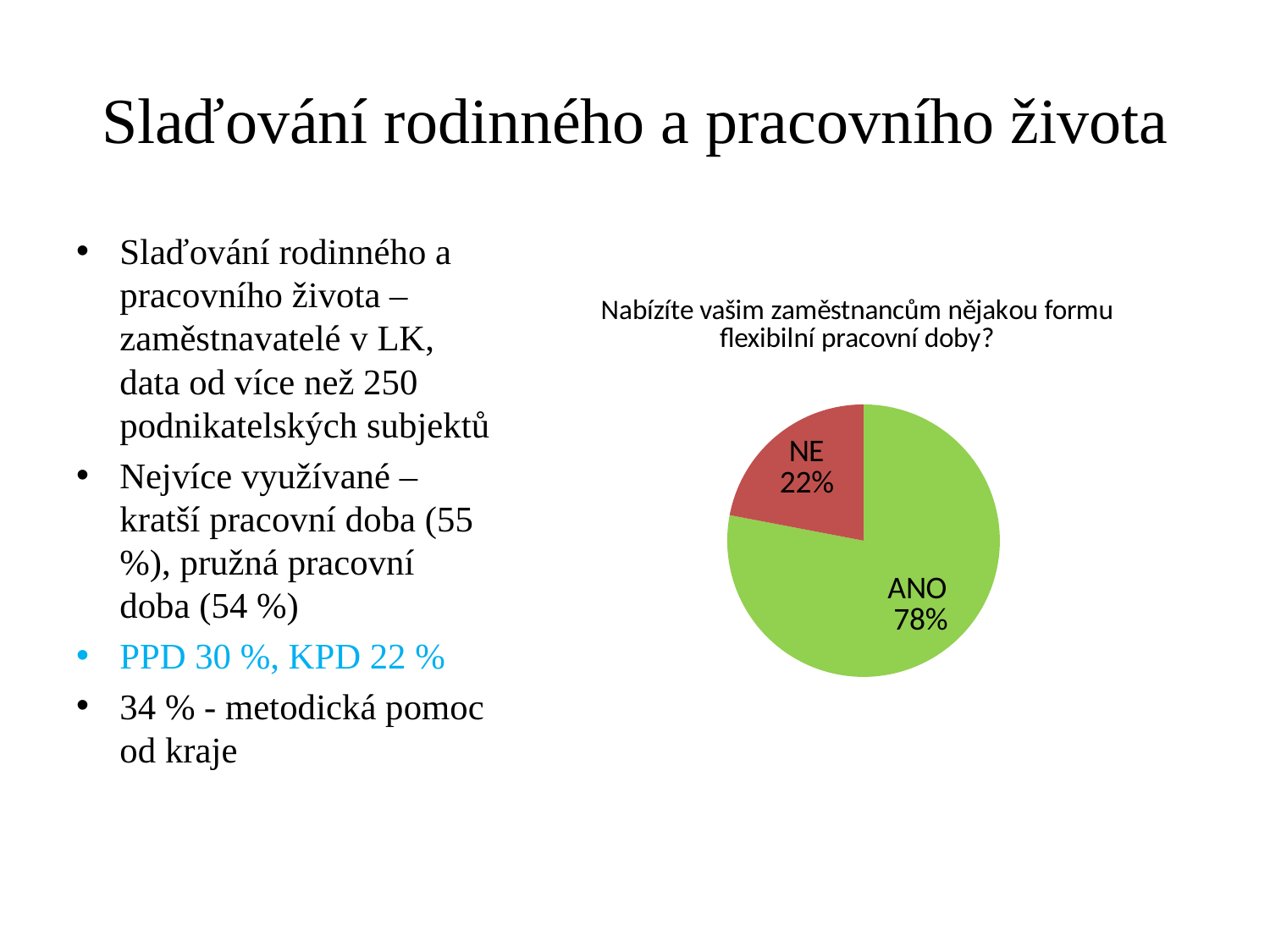
What is the total of the two slices shown in the pie chart? 100% What colour is the ANO slice of the pie chart? green What is the title of the pie chart? Nabízíte vašim zaměstnancům nějakou formu flexibilní pracovní doby? How many slices does the pie chart have? 2 Which slice of the pie chart is the largest? ANO Which is larger, the ANO slice or the NE slice? ANO What share of the pie does the NE slice represent? 22% Which slice of the pie chart is the smallest? NE What share of the pie does the ANO slice represent? 78% What is the difference in percentage points between the ANO and NE slices? 56 What kind of chart is shown on the slide? pie chart